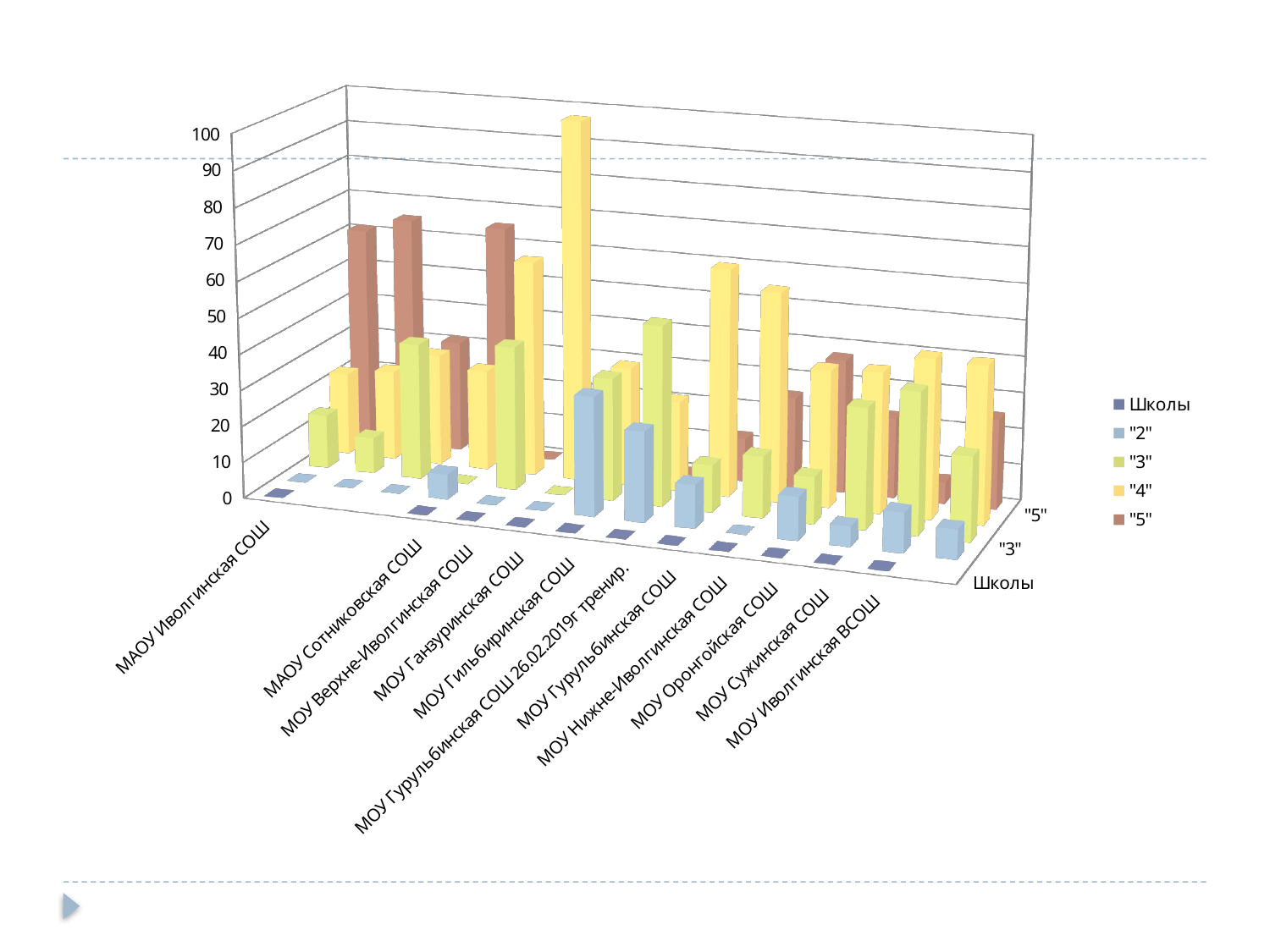
How many series does the legend list? 5 What is the highest value shown on the vertical axis? 100 Which series has the lowest bars across the chart? Школы What kind of chart is shown on the slide? bar chart What is the first entry in the chart legend? Школы Which series contains the tallest bar in the chart? "4" What is the label of the first category on the horizontal axis? МАОУ Иволгинская СОШ Which colour represents the "4" series in the chart? yellow What is the label of the last category on the horizontal axis? МОУ Иволгинская ВСОШ